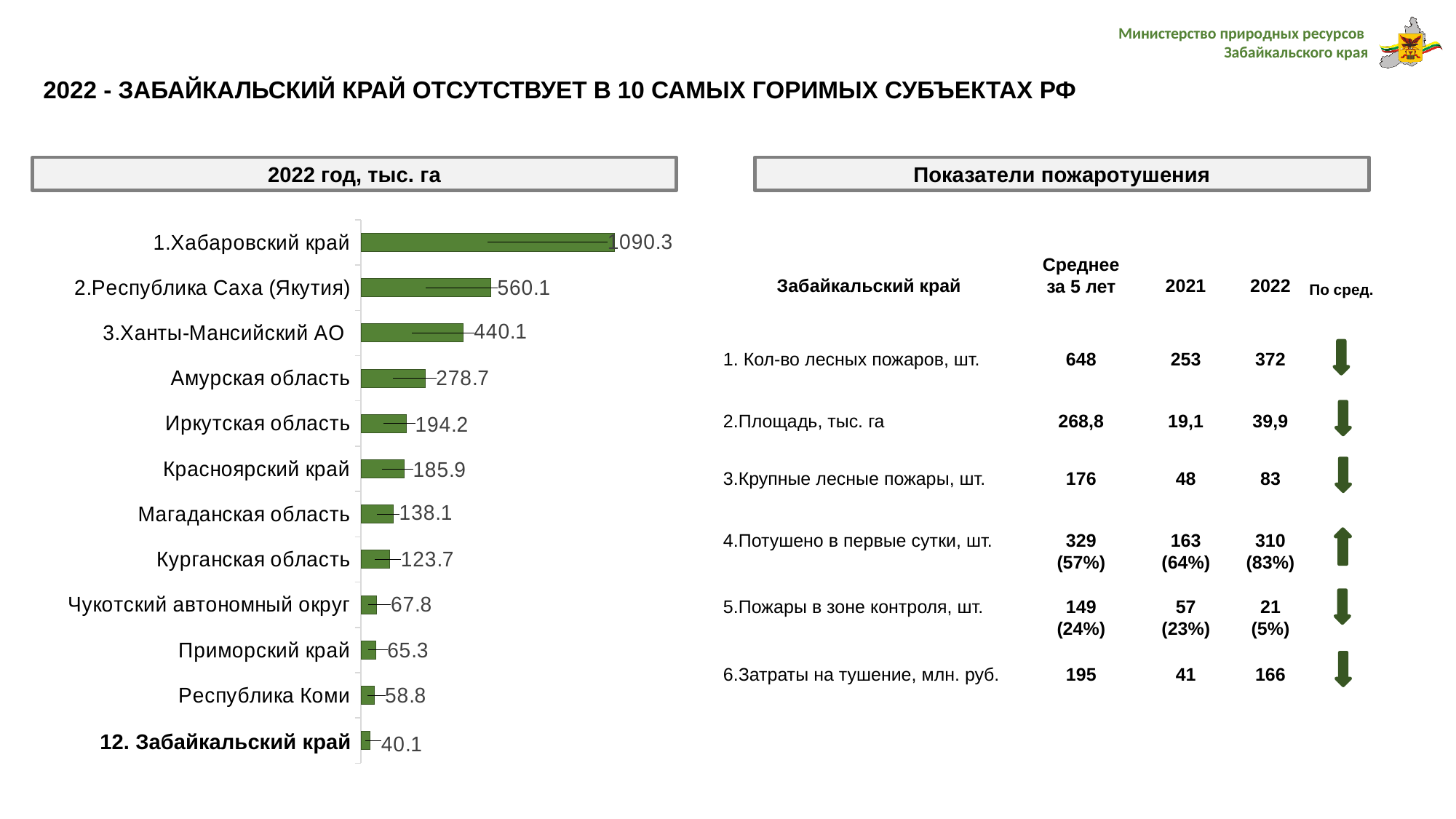
What is the value for Хабаровский край in the chart? 1090.3 Which has a larger value, Магаданская область or Курганская область? Магаданская область What is the title of the chart? 2022 год, тыс. га What is the value for Республика Коми in the chart? 58.8 What kind of chart is shown on the slide? Bar chart Which region has the lowest value in the chart? Забайкальский край What is the difference between the values for Иркутская область and Красноярский край? 8.3 What is the value for Забайкальский край in the chart? 40.1 How many regions are shown in the chart? 12 What is the value for Амурская область in the chart? 278.7 What is the difference between the values for Республика Саха (Якутия) and Ханты-Мансийский АО? 120 Which region has the highest value in the chart? Хабаровский край